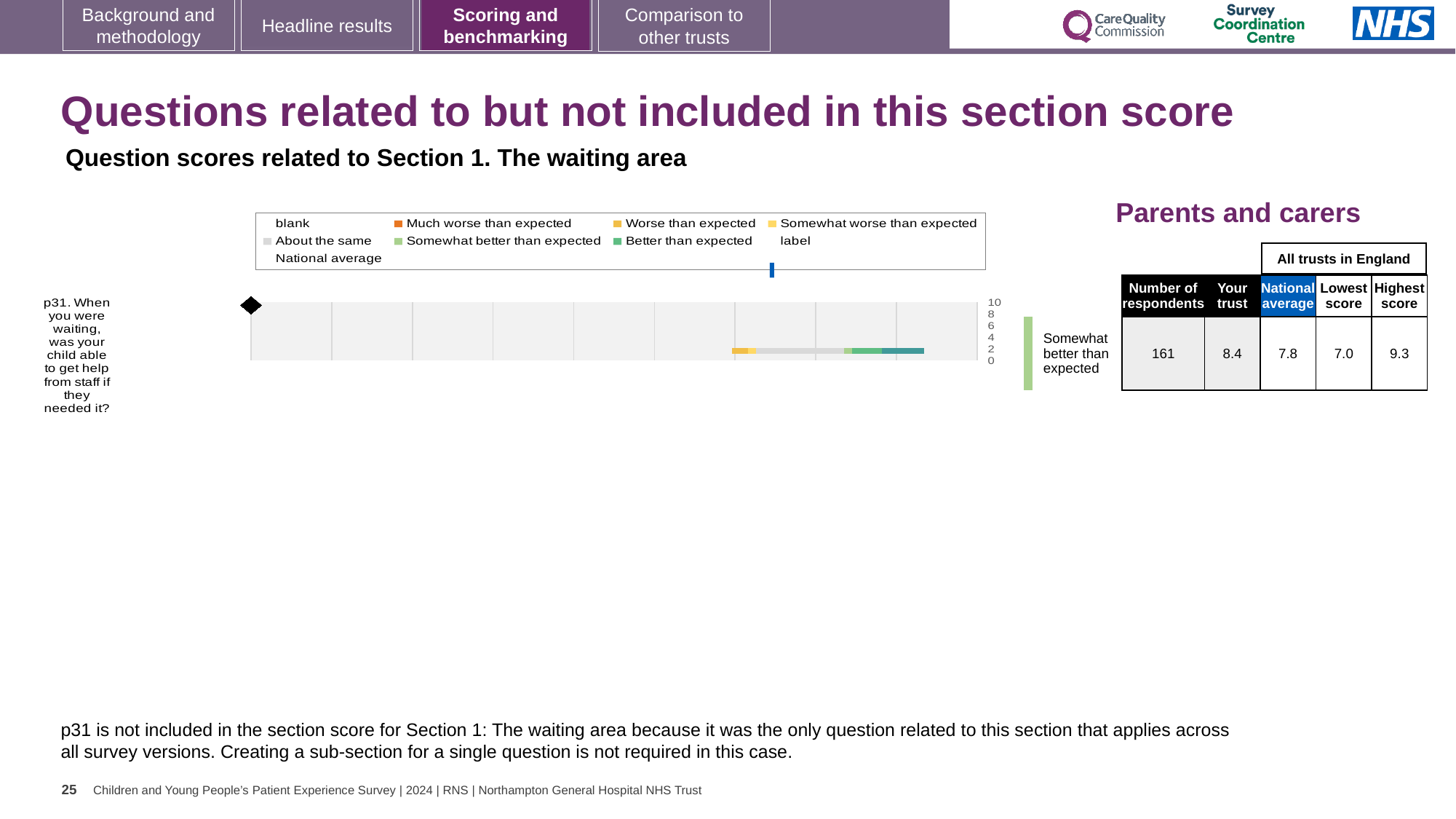
How many questions are plotted in the benchmarking chart? 1 Which is higher for question p31, the 'Your trust' score or the national average? Your trust What is the lowest score among all trusts in England for question p31? 7.0 What is the highest score among all trusts in England for question p31? 9.3 What is the 'Your trust' score for question p31? 8.4 What kind of chart is used to show the benchmarking result for question p31? bar chart How many respondents answered question p31? 161 What benchmark category is shown for question p31? Somewhat better than expected Which question is plotted in the benchmarking chart? p31. When you were waiting, was your child able to get help from staff if they needed it? What is the difference between the highest and lowest scores among all trusts in England for question p31? 2.3 What is the difference between the 'Your trust' score and the national average for question p31? 0.6 What is the national average score for question p31? 7.8